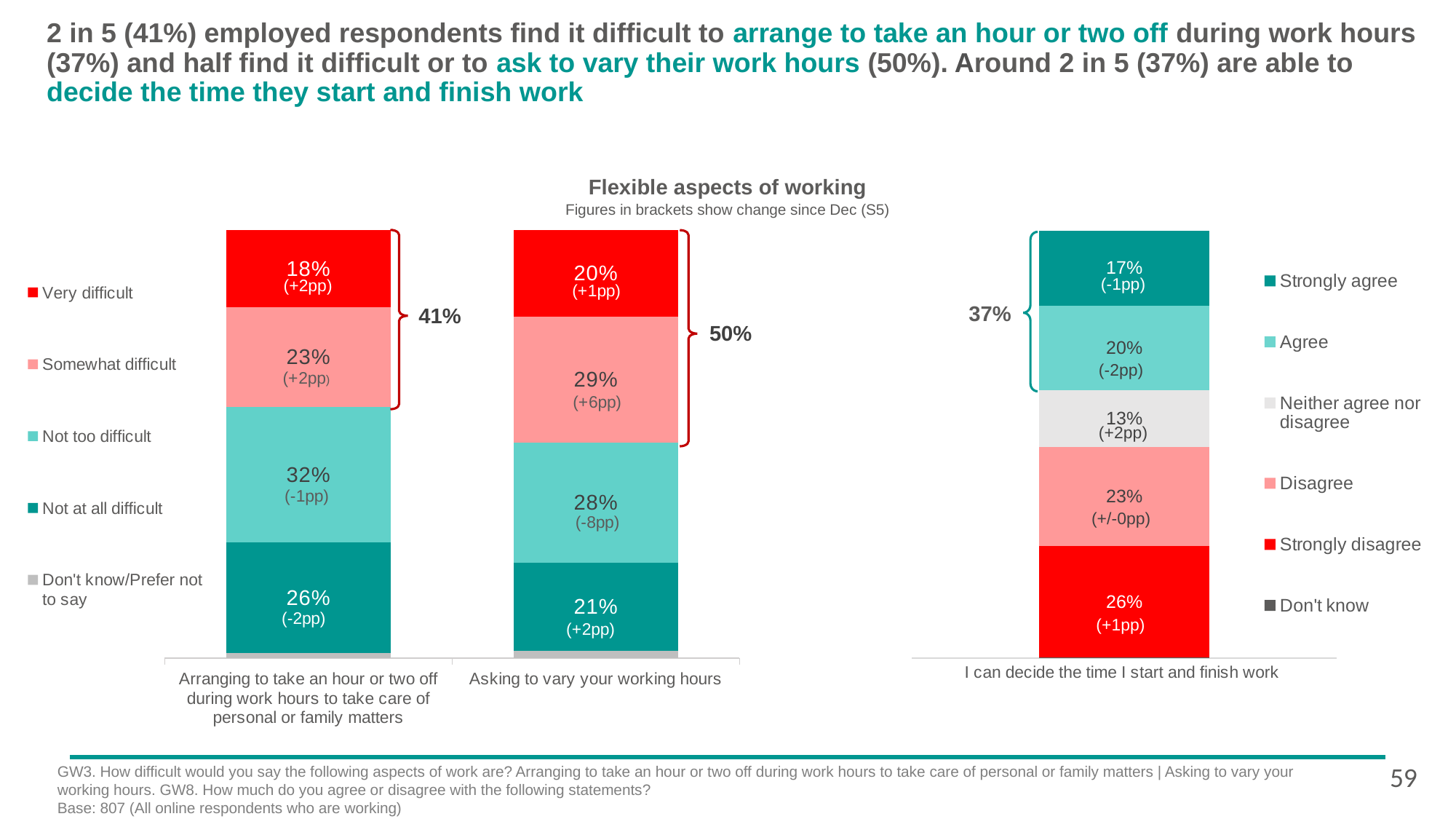
In the left chart, what percentage find asking to vary their working hours 'Somewhat difficult'? 29% In the left chart, what percentage of respondents find arranging to take an hour or two off during work hours 'Very difficult'? 18% In the right chart, what percentage 'Strongly disagree' that they can decide the time they start and finish work? 26% In the right chart, what is the combined share of 'Strongly agree' and 'Agree'? 37% In the left chart, which response category is largest for 'Arranging to take an hour or two off during work hours'? Not too difficult In the left chart, which aspect has the higher 'Not at all difficult' share: arranging to take an hour or two off, or asking to vary working hours? Arranging to take an hour or two off How many categories (bars) are shown in the left chart? 2 What type of chart is used on this slide? Stacked bar chart In the left chart, what is the combined share of 'Very difficult' and 'Somewhat difficult' for asking to vary your working hours? 50% How many entries does the legend of the right chart list? 6 In the left chart, what is the difference between the 'Not too difficult' shares for the two aspects of working? 4 percentage points